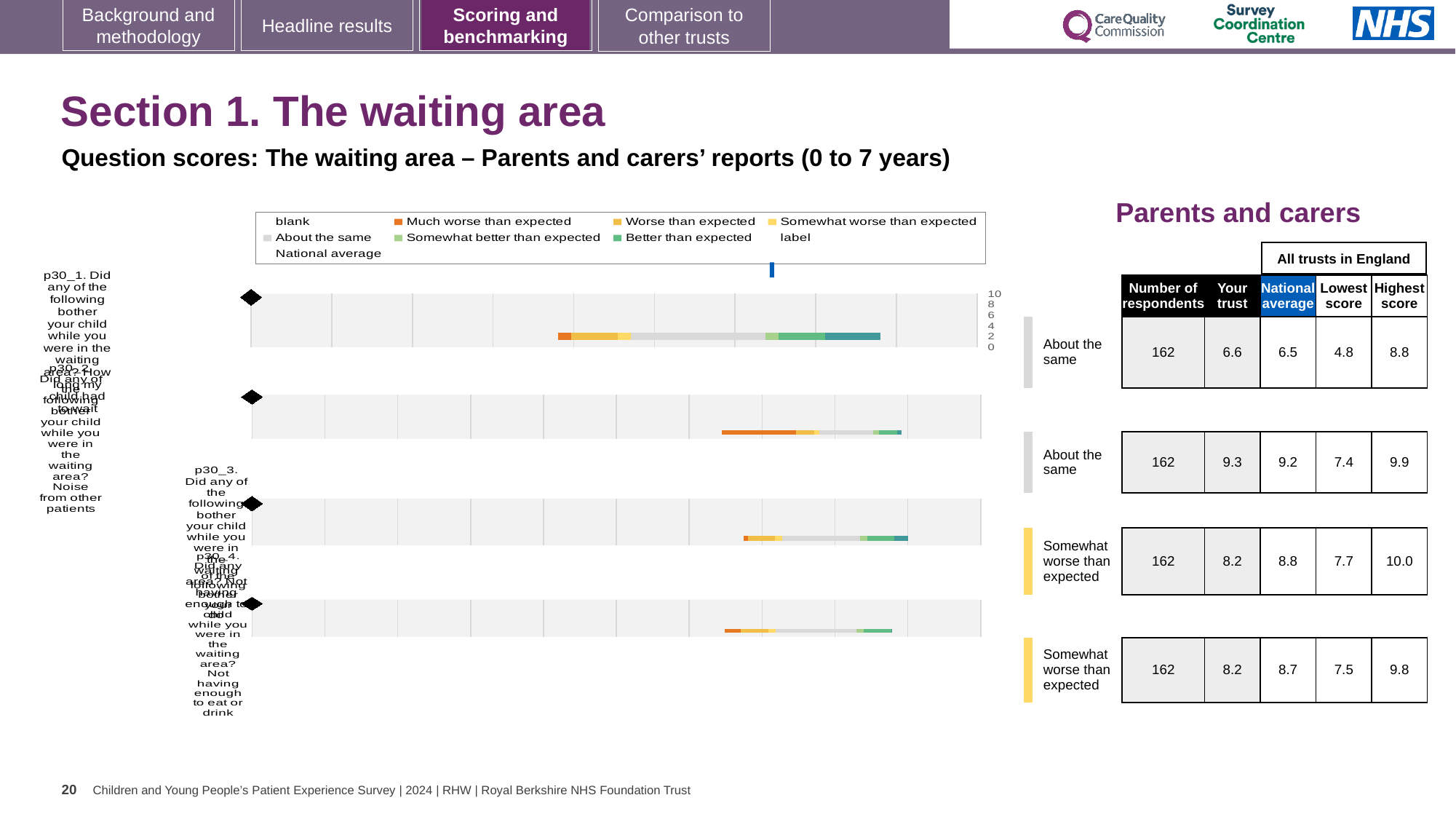
What is the lowest value in the 'Lowest score' column of the Parents and carers table? 4.8 How many respondents are listed for each question in the Parents and carers table? 162 In the chart legend, what colour represents 'Much worse than expected'? orange Which row has the highest 'Your trust' score in the Parents and carers table? the second row (9.3) What is the 'Highest score' for the third row of the Parents and carers table? 10.0 What benchmark category is shown for the fourth row of the Parents and carers table? Somewhat worse than expected For the first row, which is larger: the 'Your trust' score or the national average? Your trust (6.6) What is the 'Your trust' score for the first row of the Parents and carers table? 6.6 What is the national average for the second row of the Parents and carers table? 9.2 What kind of chart is used to show the question scores for the waiting area? bar chart For the third row, what is the difference between the national average (8.8) and the 'Your trust' score (8.2)? 0.6 How many question rows (bars) are plotted in the waiting area chart? 4